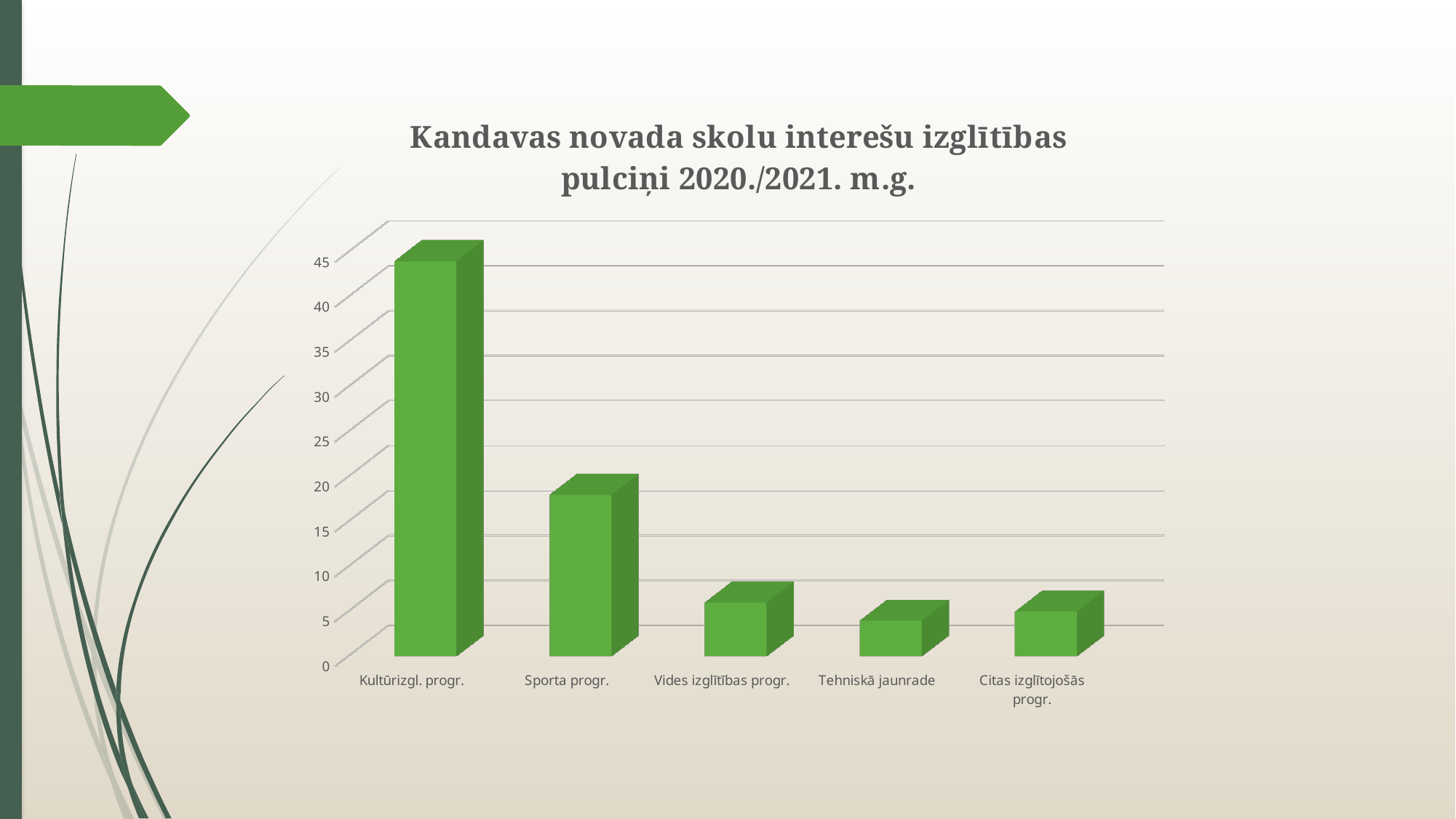
Is the value for Citas izglītojošās progr. greater or less than 10? less Which is larger, the value for Sporta progr. or the value for Vides izglītības progr.? Sporta progr. Is the value for Kultūrizgl. progr. greater or less than 40? greater Is the value for Sporta progr. greater or less than 20? less How many categories are shown on the x axis of the chart? 5 What kind of chart is shown on the slide? bar chart What colour are the bars in the chart? green Which category has the highest value in the chart? Kultūrizgl. progr. Which is larger, the value for Kultūrizgl. progr. or the value for Sporta progr.? Kultūrizgl. progr. What is the title of the chart? Kandavas novada skolu interešu izglītības pulciņi 2020./2021. m.g.